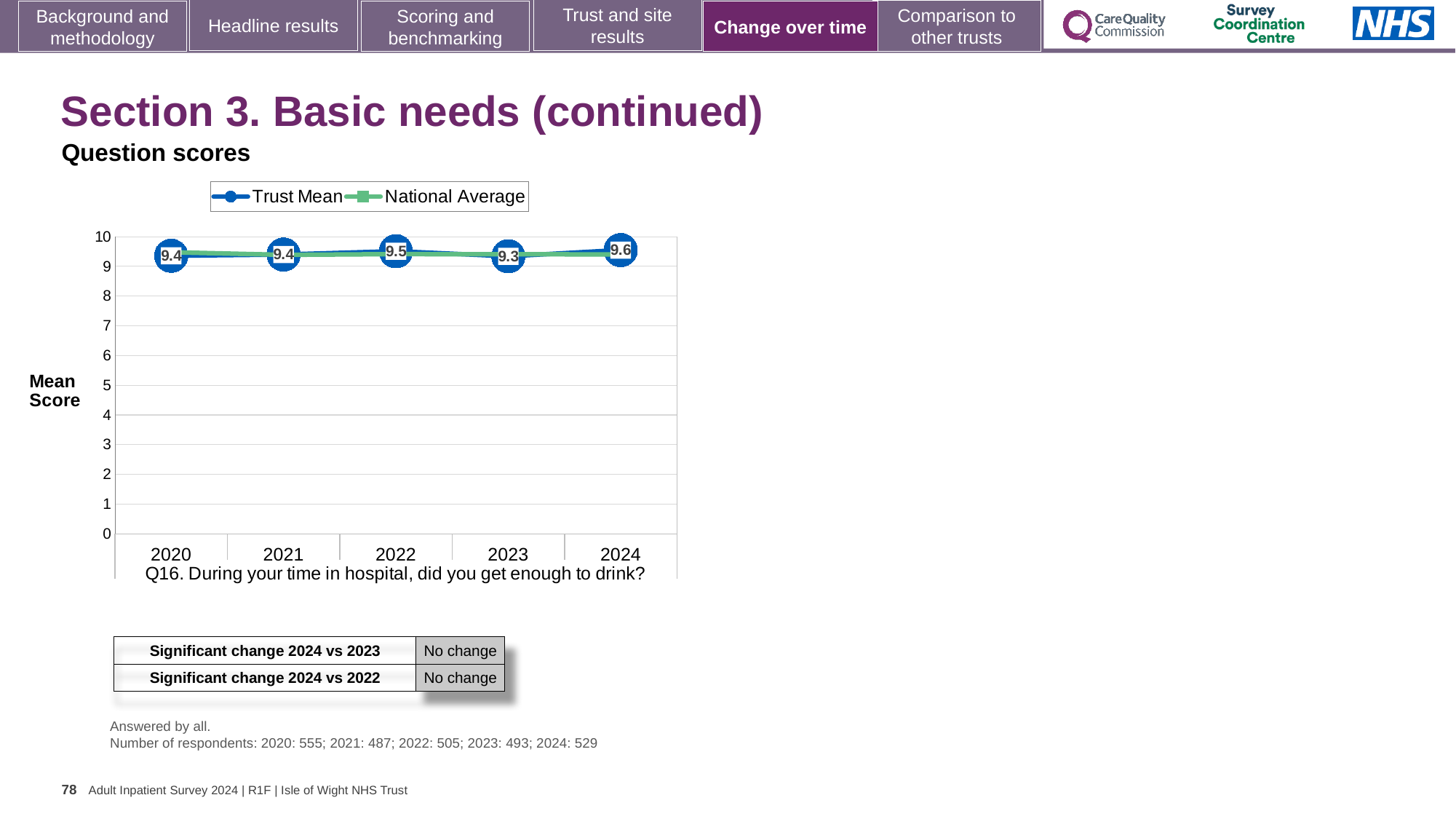
How many series does the legend list? 2 What is the Trust Mean score for 2020? 9.4 What is the Trust Mean score for 2022? 9.5 In which year is the Trust Mean score highest? 2024 What kind of chart is shown on the slide? Line chart Is the Trust Mean score for 2021 greater or less than 9? greater In which year is the Trust Mean score lowest? 2023 What is the difference between the Trust Mean score in 2024 and in 2023? 0.3 What is the Trust Mean score for 2024? 9.6 How many years are plotted on the x axis? 5 Is the Trust Mean score for 2022 larger than the Trust Mean score for 2023? Yes What is the Trust Mean score for 2023? 9.3